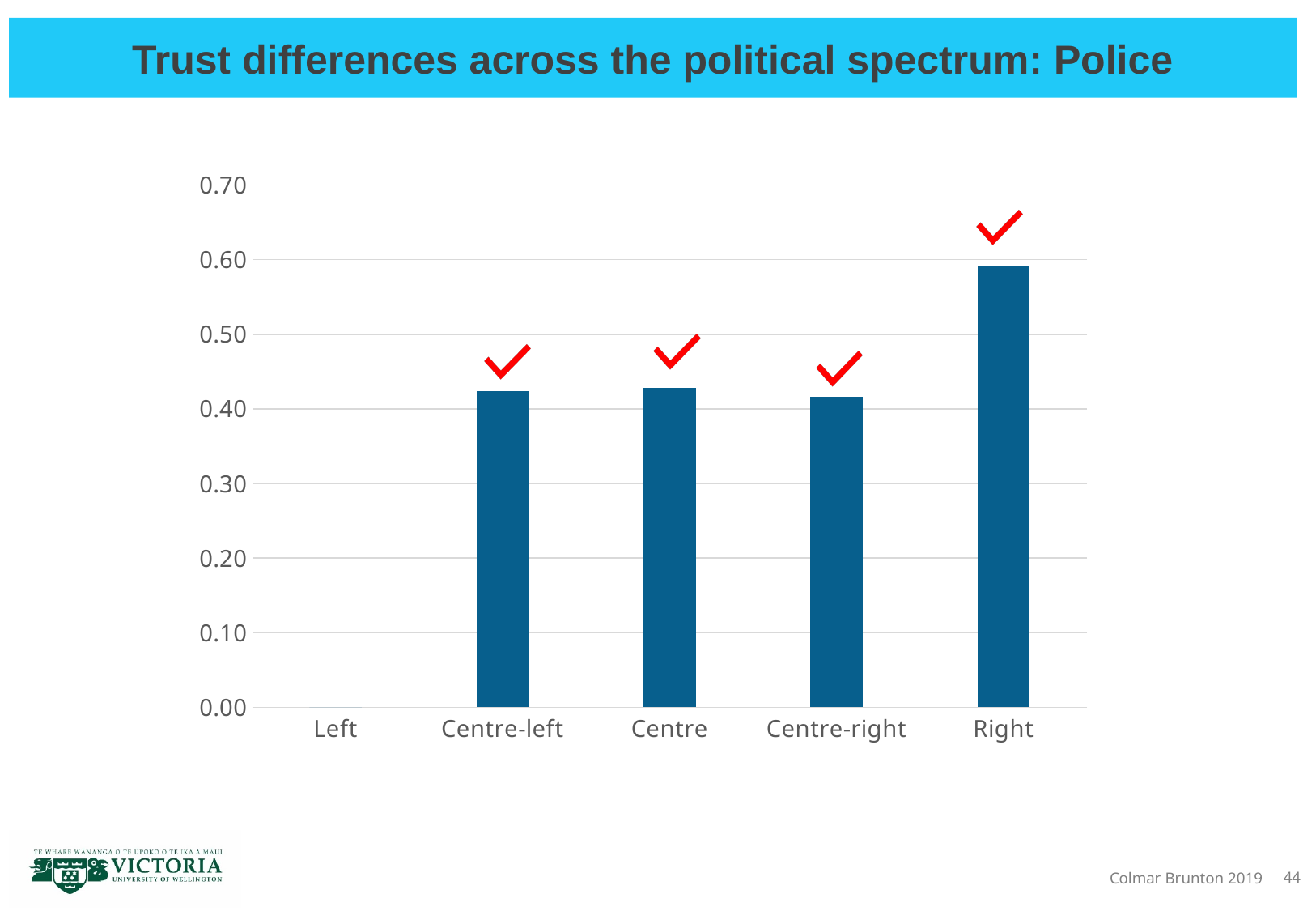
Is the value for Centre-left greater or less than 0.30? greater What kind of chart is shown on the slide? bar chart Is the value for Centre greater or less than 0.40? greater Which is larger, the value for Centre-right or the value for Right? Right Which category on the x axis has no bar plotted? Left Which is larger, the value for Right or the value for Centre? Right How many categories are shown on the x axis? 5 What is the title of the slide? Trust differences across the political spectrum: Police Is the value for Right greater or less than 0.50? greater Which category has the highest value? Right